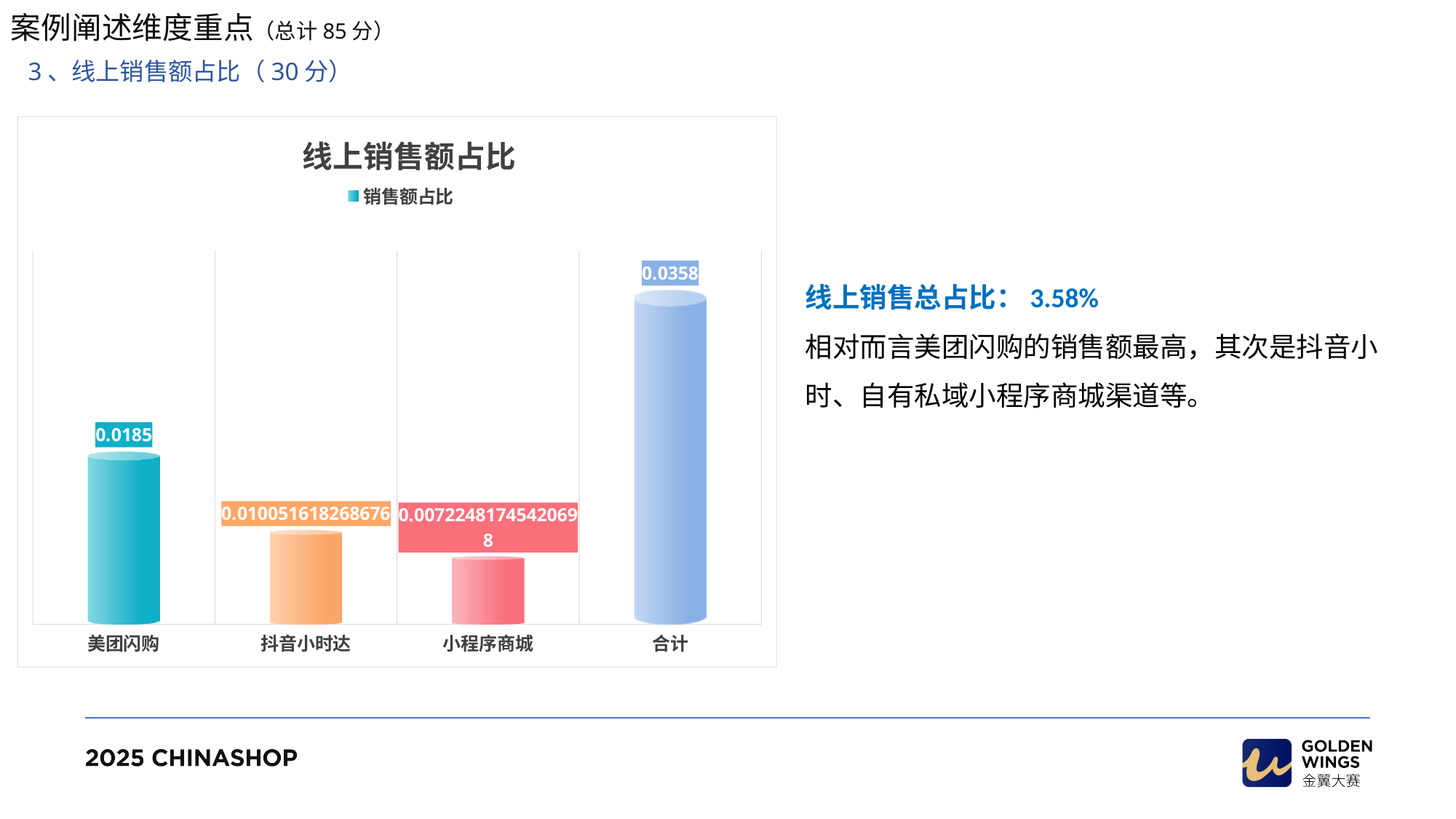
What is the value for 抖音小时达? 0.010051618268676 How many categories are shown on the x axis? 4 How many series does the legend list? 1 What is the value for 合计? 0.0358 Which category has the lowest value? 小程序商城 Which is larger, the value for 美团闪购 or the value for 抖音小时达? 美团闪购 Which category has the highest value? 合计 What is the value for 小程序商城? 0.00722481745420698 What is the value for 美团闪购? 0.0185 What type of chart is shown on the slide? bar chart What is the title of the chart? 线上销售额占比 What is the difference between the value for 合计 and the value for 美团闪购? 0.0173